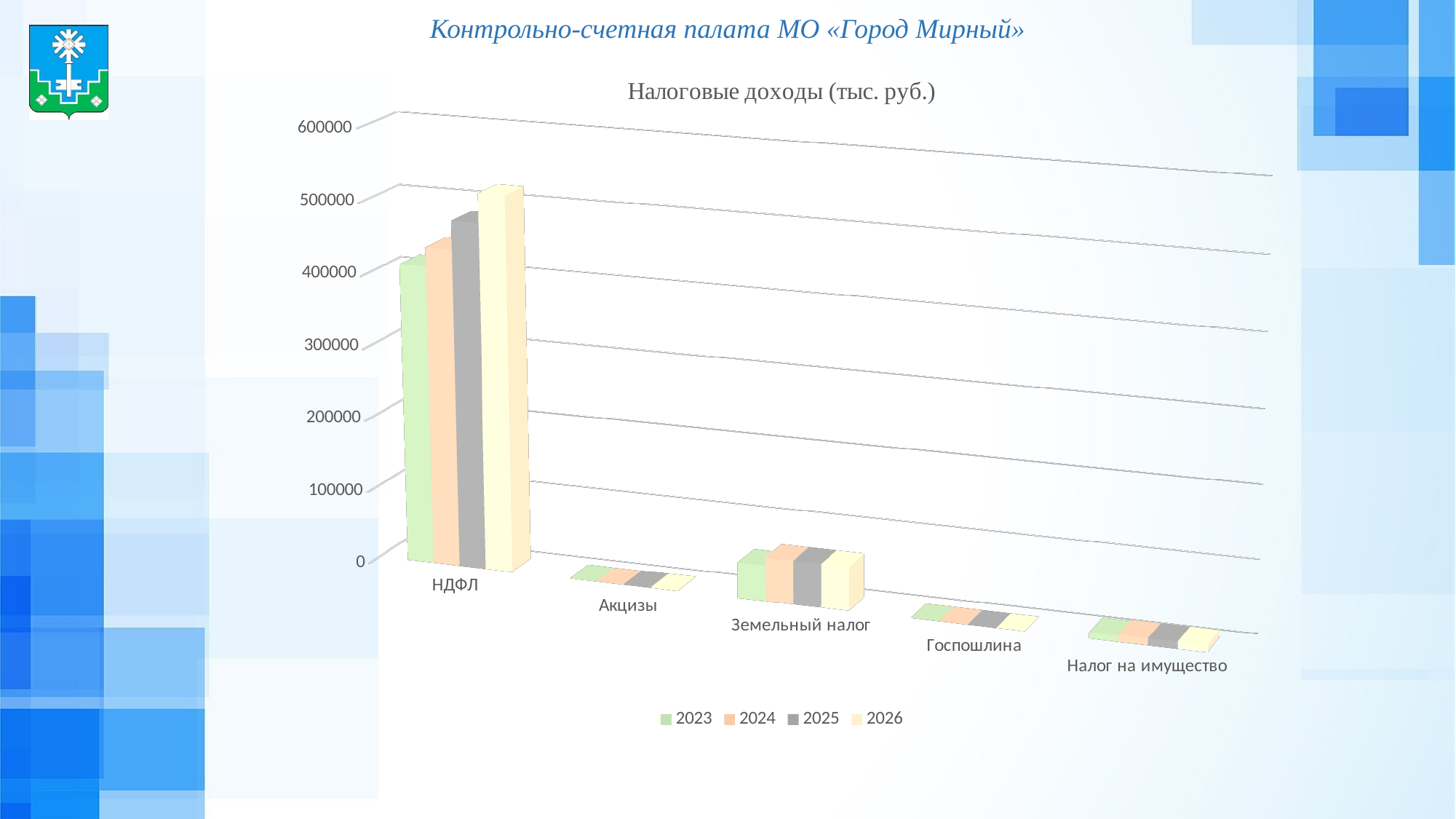
Do the values for НДФЛ rise or fall from 2023 to 2026? rise Is the value for НДФЛ in 2026 greater or less than 400000? greater Which category has the highest values in the chart? НДФЛ How many categories are shown on the x axis of the chart? 5 Which series are listed in the legend? 2023, 2024, 2025, 2026 What is the title of the chart? Налоговые доходы (тыс. руб.) Is the value for НДФЛ in 2023 greater or less than 300000? greater Is the value for Земельный налог in 2026 greater or less than 100000? less What kind of chart is shown on the slide? bar chart How many series does the legend list? 4 Which is larger in 2024: Земельный налог or Акцизы? Земельный налог